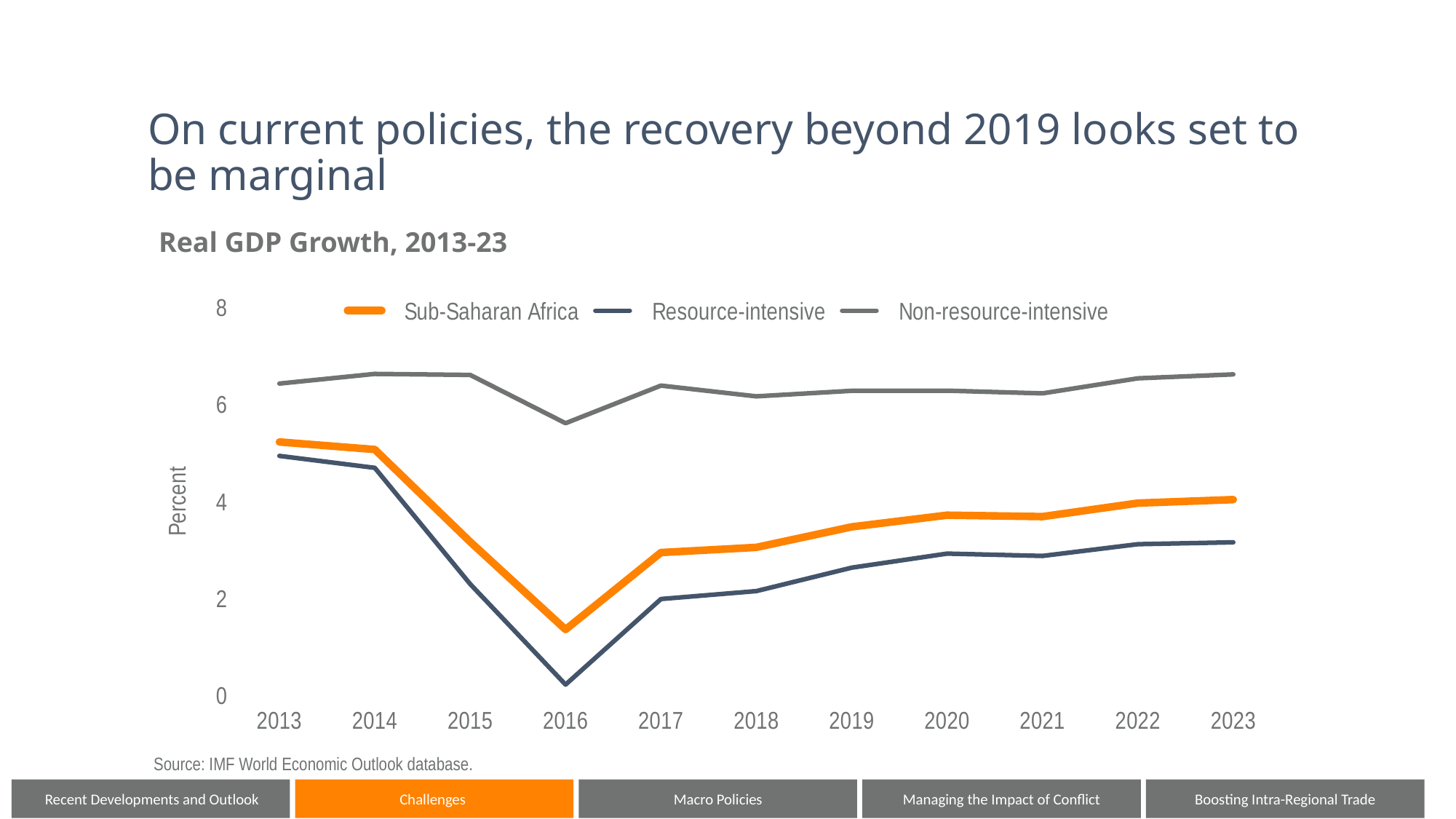
In which year does the Resource-intensive line reach its lowest value? 2016 Does the Resource-intensive line rise or fall from 2013 to 2016? fall In 2016, which is larger: Sub-Saharan Africa or Resource-intensive? Sub-Saharan Africa In which year does the Sub-Saharan Africa line reach its lowest value? 2016 Is the value for Sub-Saharan Africa in 2013 greater or less than 4? greater Is the value for Non-resource-intensive in 2013 greater or less than 6? greater How many series does the legend list? 3 Is the value for Resource-intensive in 2016 greater or less than 2? less What is the title of the chart? Real GDP Growth, 2013-23 What kind of chart is shown on the slide? line chart How many years are plotted along the x axis? 11 Which series has the highest value in 2023? Non-resource-intensive